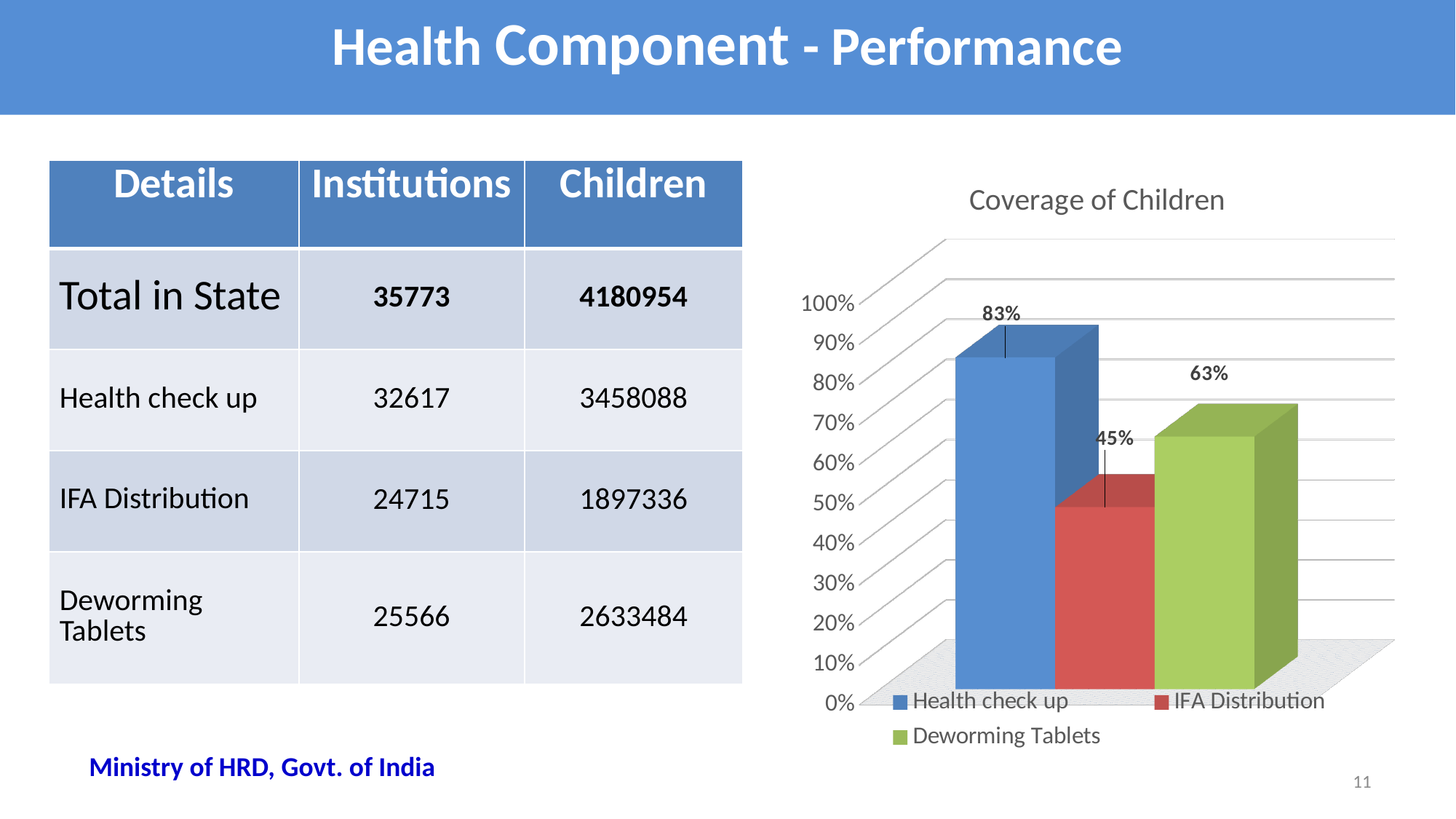
Which is larger, the coverage for Deworming Tablets or IFA Distribution? Deworming Tablets What is the difference between the coverage for Health check up and IFA Distribution? 38% Is the value for IFA Distribution greater or less than 50%? less Which series has the highest coverage? Health check up What is the title of the chart? Coverage of Children What is the coverage value for IFA Distribution? 45% What is the coverage value for Deworming Tablets? 63% What is the coverage value for Health check up? 83% What is the difference between the coverage for Deworming Tablets and IFA Distribution? 18% What type of chart is shown on the slide? bar chart Which series has the lowest coverage? IFA Distribution How many series does the legend list? 3